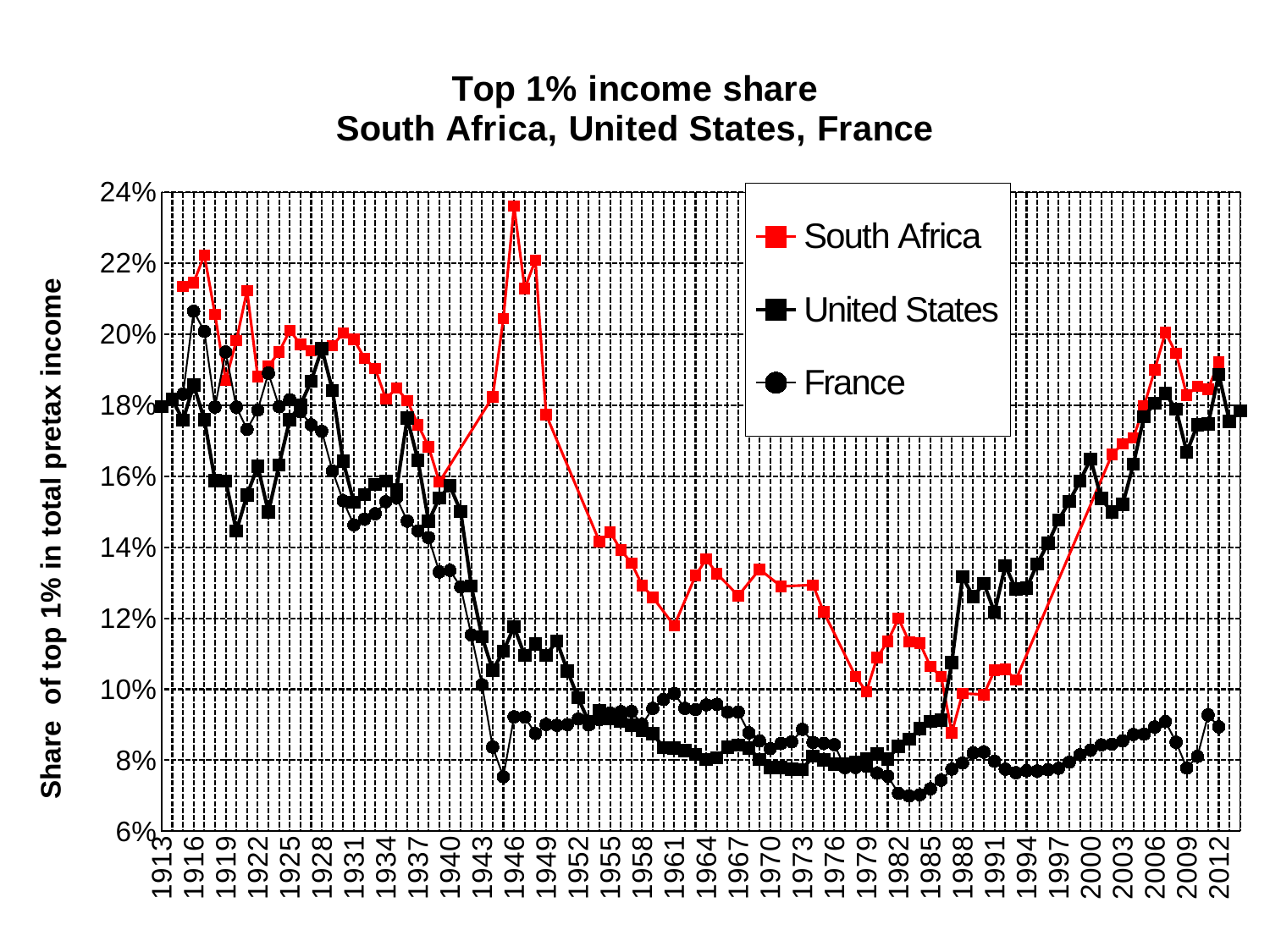
Which series has the lowest value in 2000? France What kind of chart is shown on the slide? line chart Is the value for South Africa in 1946 greater or less than 22%? greater Which series has the highest value in 1946? South Africa Which series is plotted with circular markers? France Is the value for France in 1982 greater or less than 8%? less What is the title of the chart? Top 1% income share South Africa, United States, France Is the value for the United States in 1976 greater or less than 10%? less In 1955, which is larger: the value for South Africa or the value for the United States? South Africa How many series does the legend list? 3 Does the value for France generally rise or fall from 1913 to 1982? fall